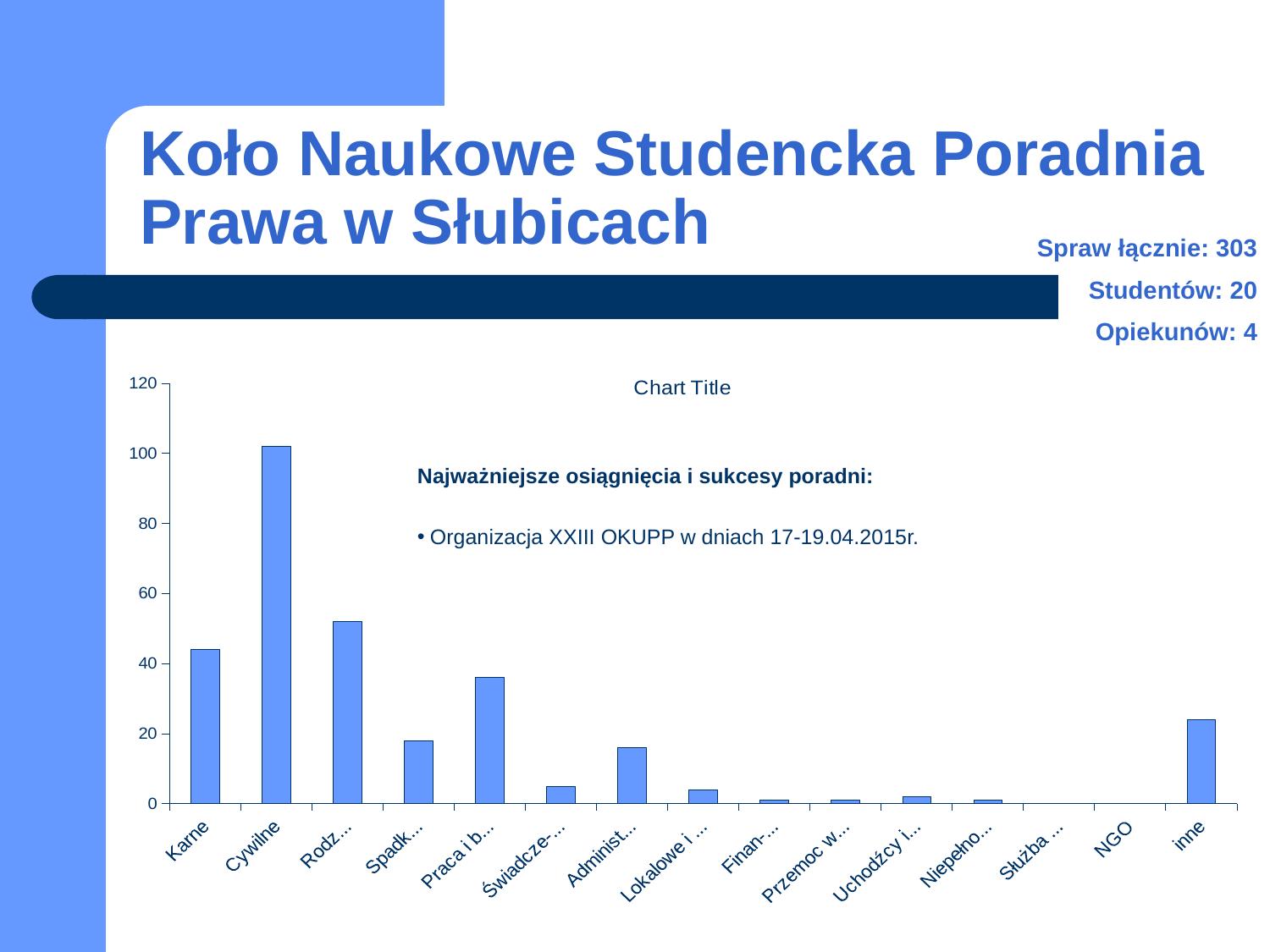
Is the value for Rodz... greater or less than 40? greater Is the value for Praca i b... greater or less than 20? greater Which category has the highest bar in the chart? Cywilne How many categories are shown along the x axis of the chart? 15 Is the value for Cywilne greater or less than 80? greater What is the title shown above the chart? Chart Title Which is larger, the value for Karne or the value for Rodz...? Rodz... What kind of chart is shown on the slide? bar chart Which is larger, the value for Praca i b... or the value for Administ...? Praca i b...